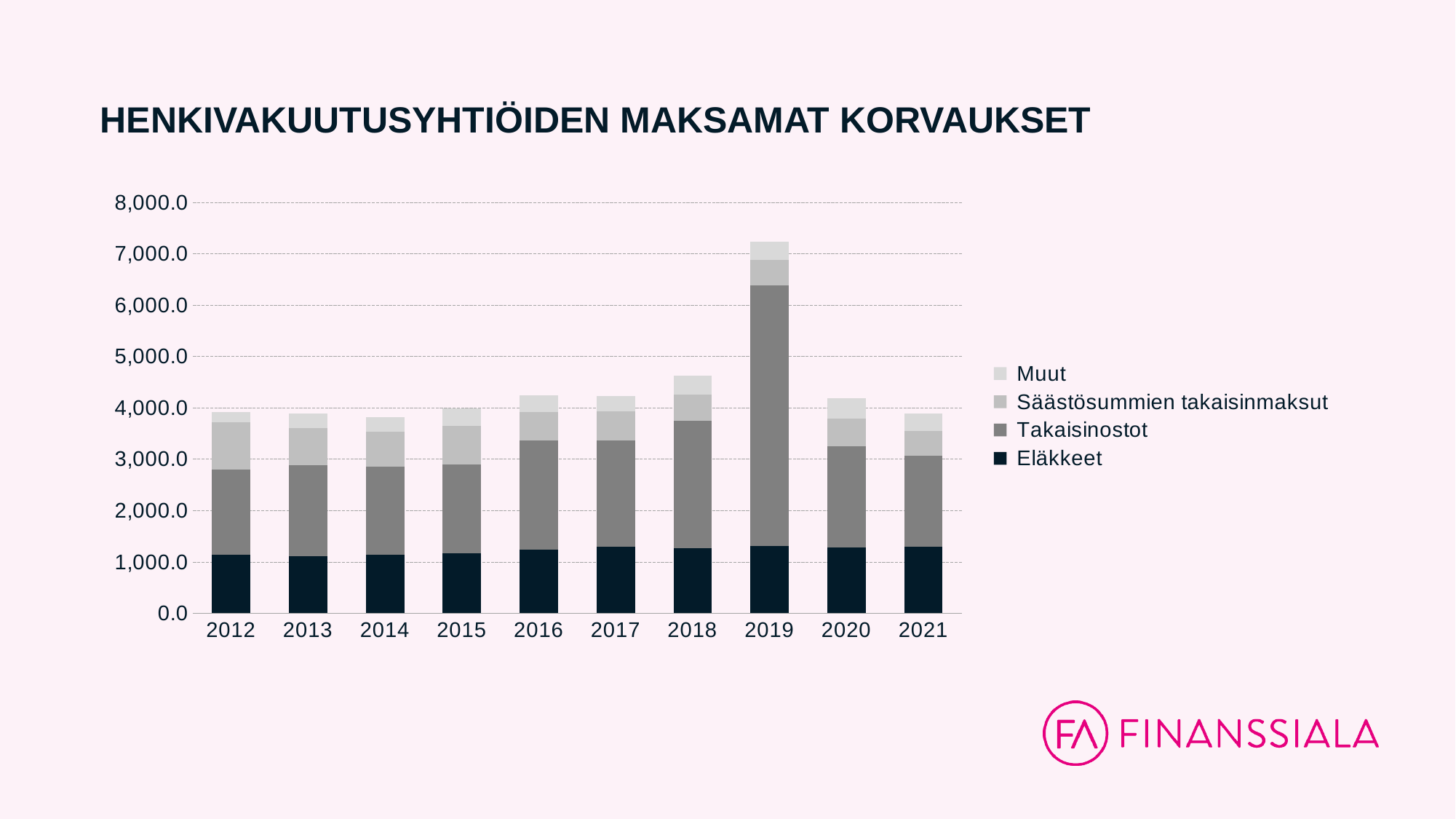
What kind of chart is shown on the slide? Stacked bar chart How many years are shown on the x axis? 10 Is the total for 2018 greater or less than 4,000? greater What is the title of the chart? HENKIVAKUUTUSYHTIÖIDEN MAKSAMAT KORVAUKSET Which year has the highest total bar? 2019 How many series does the legend list? 4 Which total is larger, 2018 or 2012? 2018 Do the total bars rise or fall from 2019 to 2021? fall Is the Takaisinostot value for 2019 greater or less than 4,000? greater Is the total for 2019 greater or less than 6,000? greater Which year has the largest Takaisinostot segment? 2019